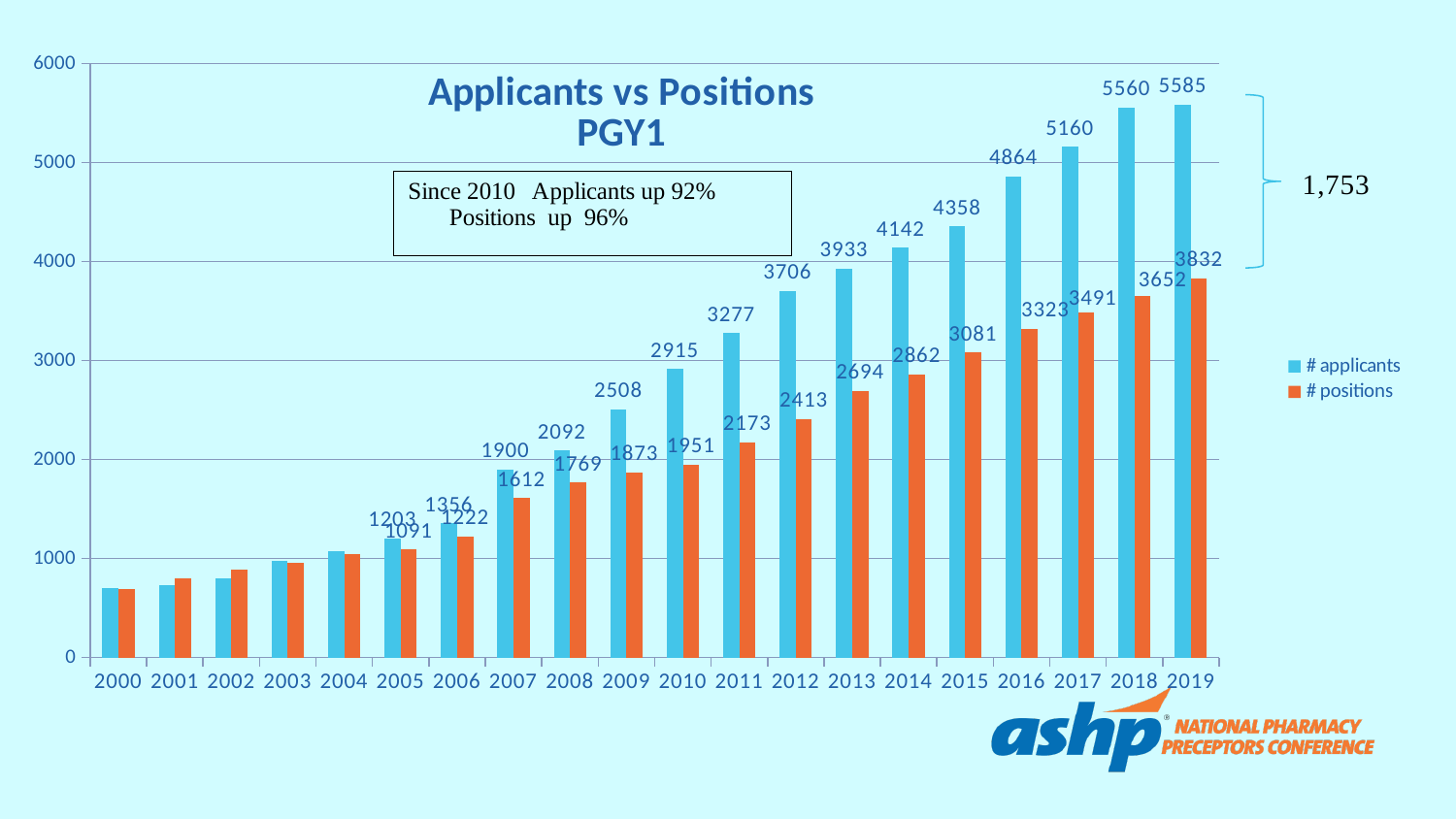
Which is larger: the number of applicants in 2012 or the number of positions in 2013? applicants in 2012 What is the difference between applicants and positions in 2019? 1753 What is the number of applicants in 2010? 2915 How many series does the legend list? 2 What kind of chart is shown on the slide? bar chart Which year has the highest number of applicants? 2019 Do the number of applicants rise or fall from 2000 to 2019? rise What is the number of positions in 2014? 2862 What is the difference between applicants and positions in 2010? 964 What is the number of applicants in 2019? 5585 How many years are shown on the x axis? 20 Is the number of applicants in 2000 greater or less than 1000? less